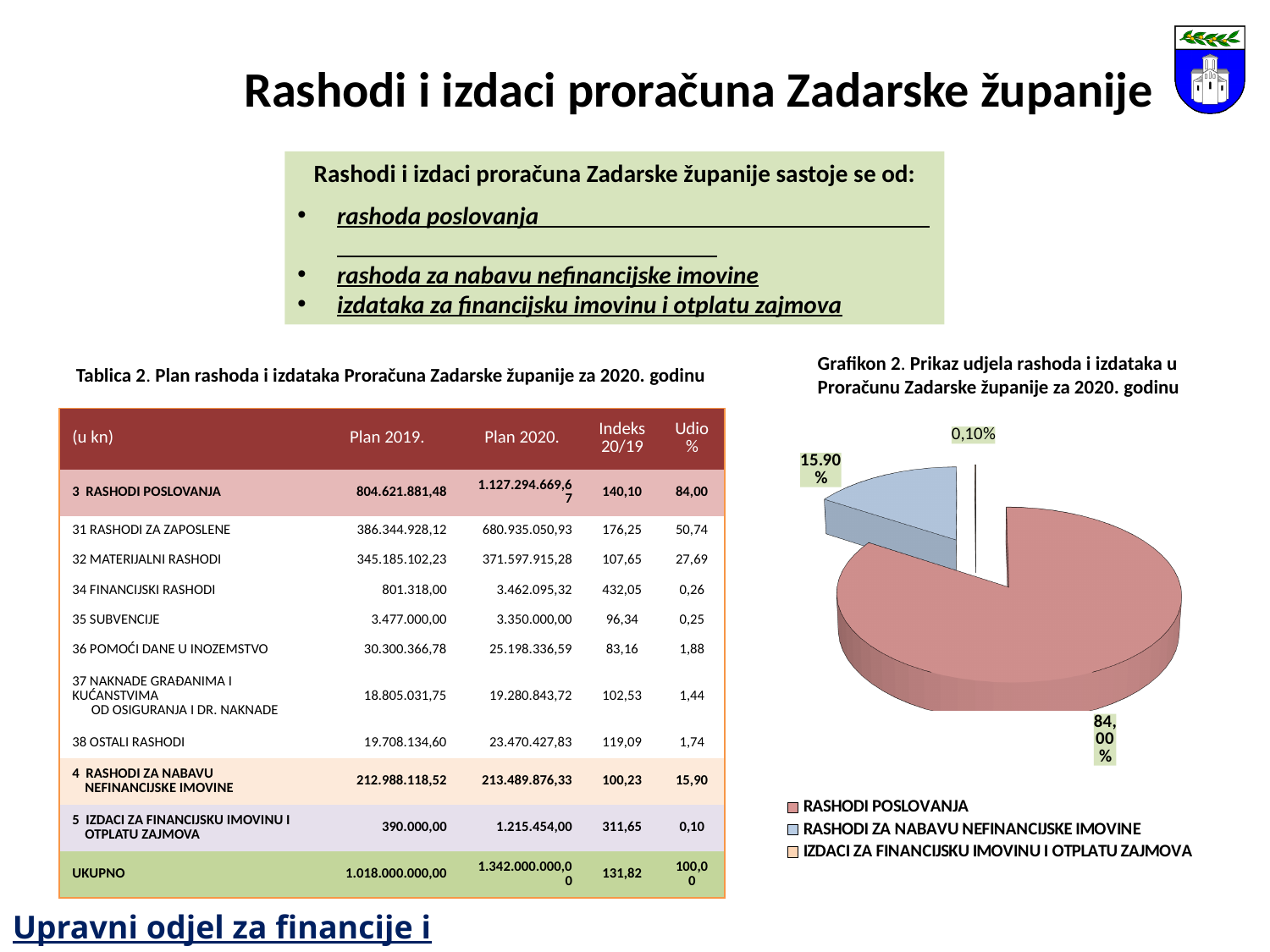
In Grafikon 2, which legend entry is shown in the pink/red colour? RASHODI POSLOVANJA What is the title of the pie chart on the slide? Grafikon 2. Prikaz udjela rashoda i izdataka u Proračunu Zadarske županije za 2020. godinu In Grafikon 2, what share of the pie is labelled for RASHODI ZA NABAVU NEFINANCIJSKE IMOVINE? 15.90% In Grafikon 2, how many entries does the legend list? 3 In Grafikon 2, what share of the pie is labelled for RASHODI POSLOVANJA? 84,00% In Grafikon 2, which category has the largest slice of the pie? RASHODI POSLOVANJA In Grafikon 2, which slice is larger: RASHODI ZA NABAVU NEFINANCIJSKE IMOVINE or IZDACI ZA FINANCIJSKU IMOVINU I OTPLATU ZAJMOVA? RASHODI ZA NABAVU NEFINANCIJSKE IMOVINE In Grafikon 2, which slice is larger: RASHODI POSLOVANJA or RASHODI ZA NABAVU NEFINANCIJSKE IMOVINE? RASHODI POSLOVANJA What kind of chart is Grafikon 2 on the slide? pie chart In Grafikon 2, what share of the pie is labelled for IZDACI ZA FINANCIJSKU IMOVINU I OTPLATU ZAJMOVA? 0,10% In Grafikon 2, which category has the smallest slice of the pie? IZDACI ZA FINANCIJSKU IMOVINU I OTPLATU ZAJMOVA In Grafikon 2, how many slices does the pie chart have? 3